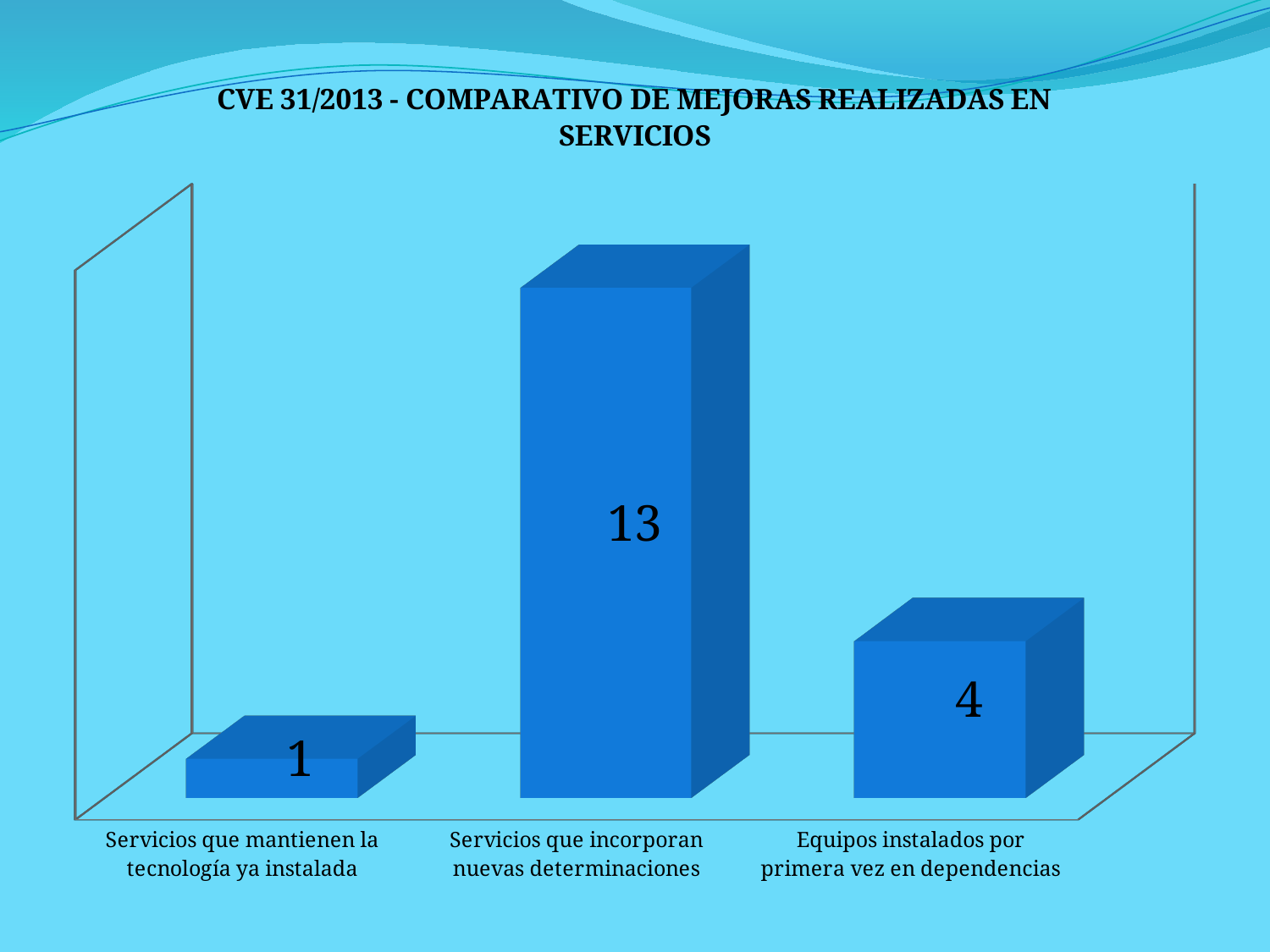
Which category has the highest value? Servicios que incorporan nuevas determinaciones What is the title of the chart? CVE 31/2013 - COMPARATIVO DE MEJORAS REALIZADAS EN SERVICIOS What is the total of the three values shown in the chart? 18 What is the value for 'Equipos instalados por primera vez en dependencias'? 4 What is the difference between the values for 'Equipos instalados por primera vez en dependencias' and 'Servicios que mantienen la tecnología ya instalada'? 3 What is the difference between the values for 'Servicios que incorporan nuevas determinaciones' and 'Equipos instalados por primera vez en dependencias'? 9 What is the value for 'Servicios que mantienen la tecnología ya instalada'? 1 Which category has the lowest value? Servicios que mantienen la tecnología ya instalada How many categories are shown in the chart? 3 Which is larger: the value for 'Equipos instalados por primera vez en dependencias' or the value for 'Servicios que mantienen la tecnología ya instalada'? Equipos instalados por primera vez en dependencias What kind of chart is shown on the slide? Bar chart What is the value for 'Servicios que incorporan nuevas determinaciones'? 13